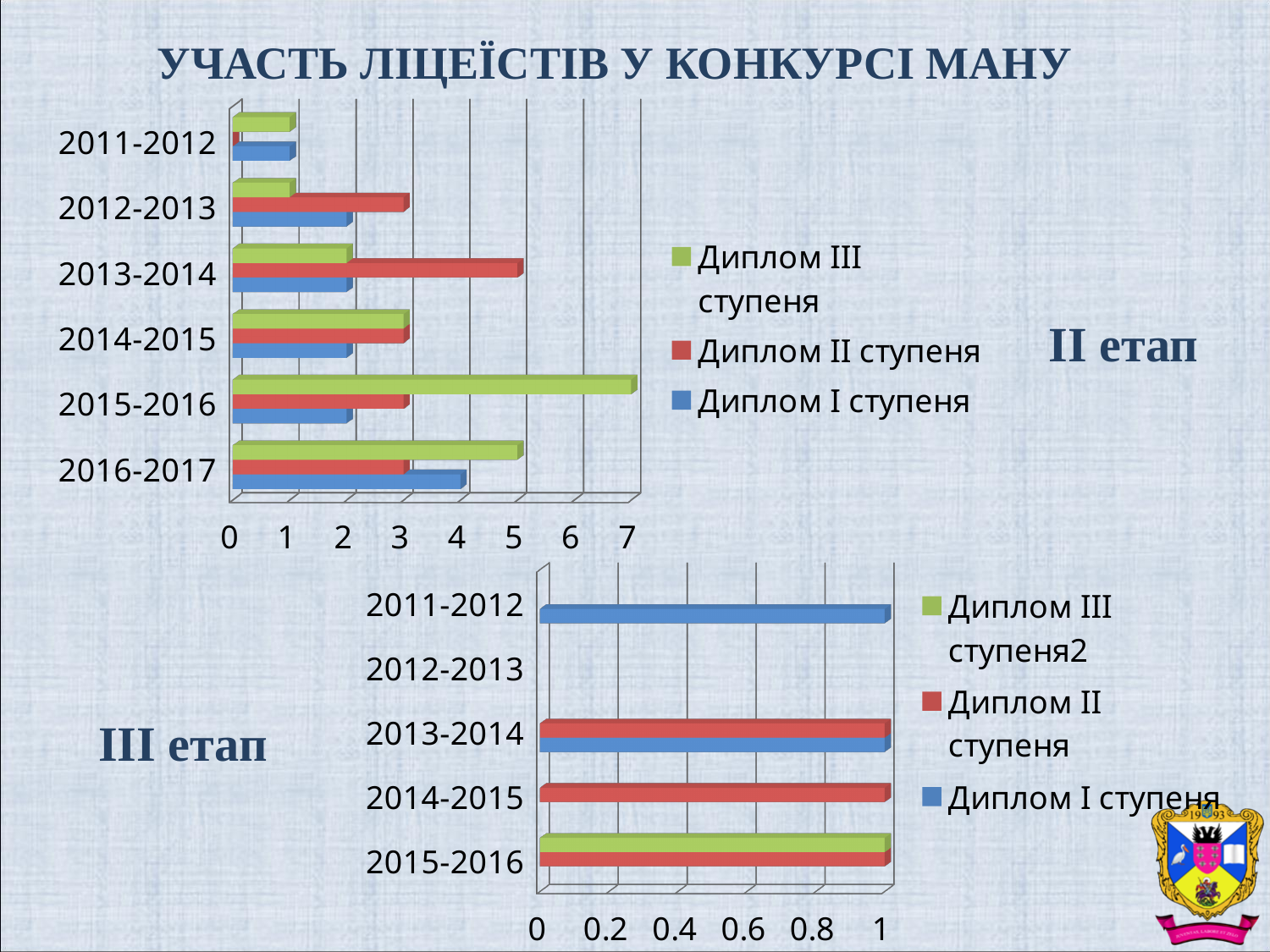
In the "II етап" chart, is the value for Диплом III ступеня in 2015-2016 greater or less than 5? greater How many school-year categories does the "III етап" chart show? 5 In the "II етап" chart, which is larger: Диплом I ступеня in 2016-2017 or Диплом I ступеня in 2015-2016? 2016-2017 How many series does the legend of the "II етап" chart list? 3 What kind of chart is the "II етап" chart at the top of the slide? bar chart How many series does the legend of the "III етап" chart list? 3 In the "II етап" chart, which school year has the highest value for Диплом III ступеня? 2015-2016 In the "III етап" chart, which school year has no bars plotted at all? 2012-2013 In the "II етап" chart, is the value for Диплом II ступеня in 2013-2014 greater or less than 4? greater In the "II етап" chart, which school year has the highest value for Диплом I ступеня? 2016-2017 How many school-year categories does the "II етап" chart show? 6 In the "II етап" chart, is the value for Диплом II ступеня in 2011-2012 greater or less than 1? less